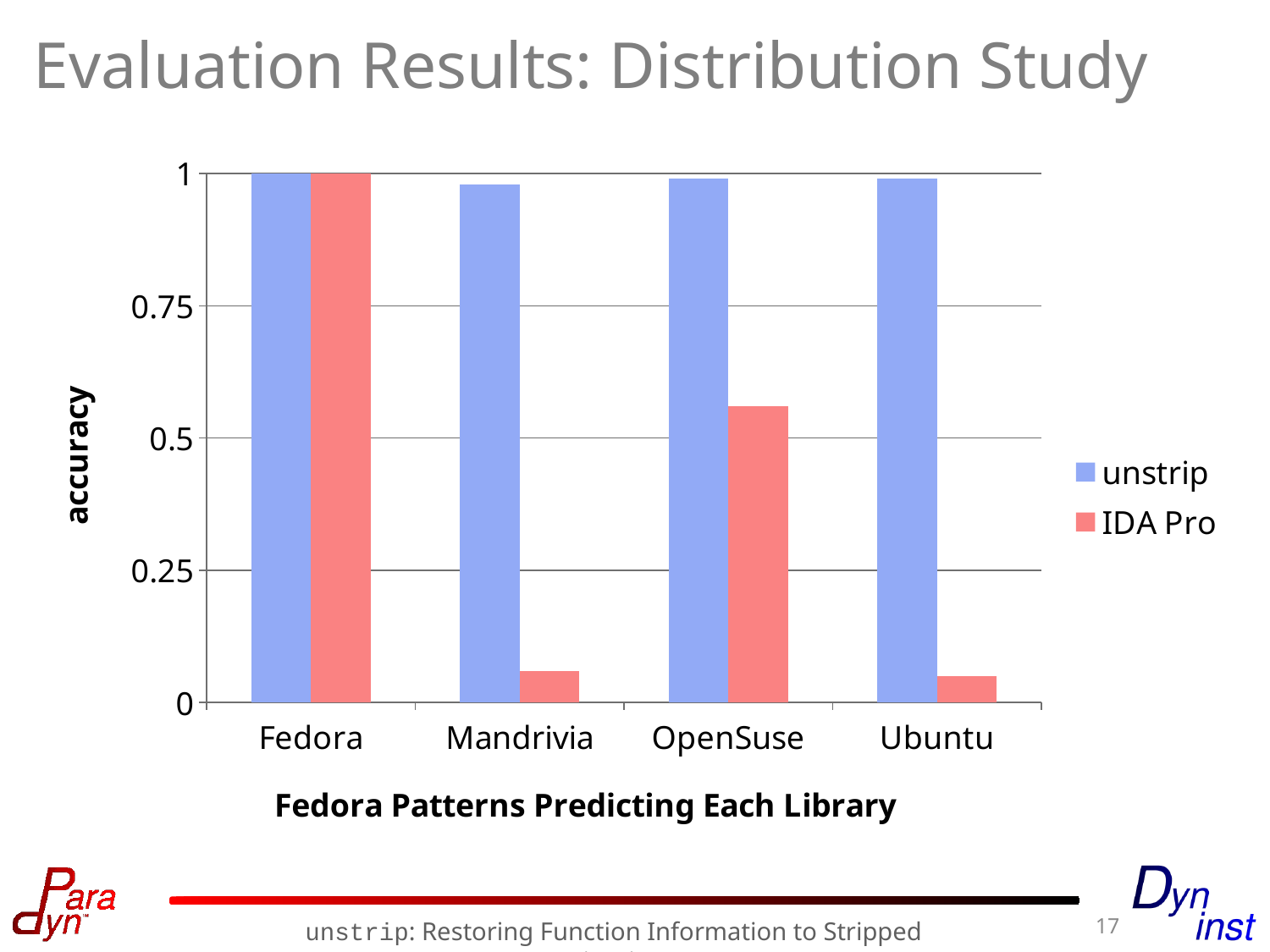
Is the unstrip accuracy for Ubuntu greater or less than 0.75? greater Which series is drawn in red/pink bars? IDA Pro How many distributions (categories) are shown on the x axis? 4 For OpenSuse, which has the higher accuracy, unstrip or IDA Pro? unstrip How many series does the legend list? 2 For which distribution is the IDA Pro accuracy highest? Fedora What kind of chart is shown on the slide? bar chart What is the label on the y axis? accuracy What is the accuracy of unstrip for Fedora? 1 Is the IDA Pro accuracy for Mandrivia greater or less than 0.25? less Is the IDA Pro accuracy for OpenSuse greater or less than 0.5? greater Which is larger, the IDA Pro accuracy for Fedora or for OpenSuse? Fedora